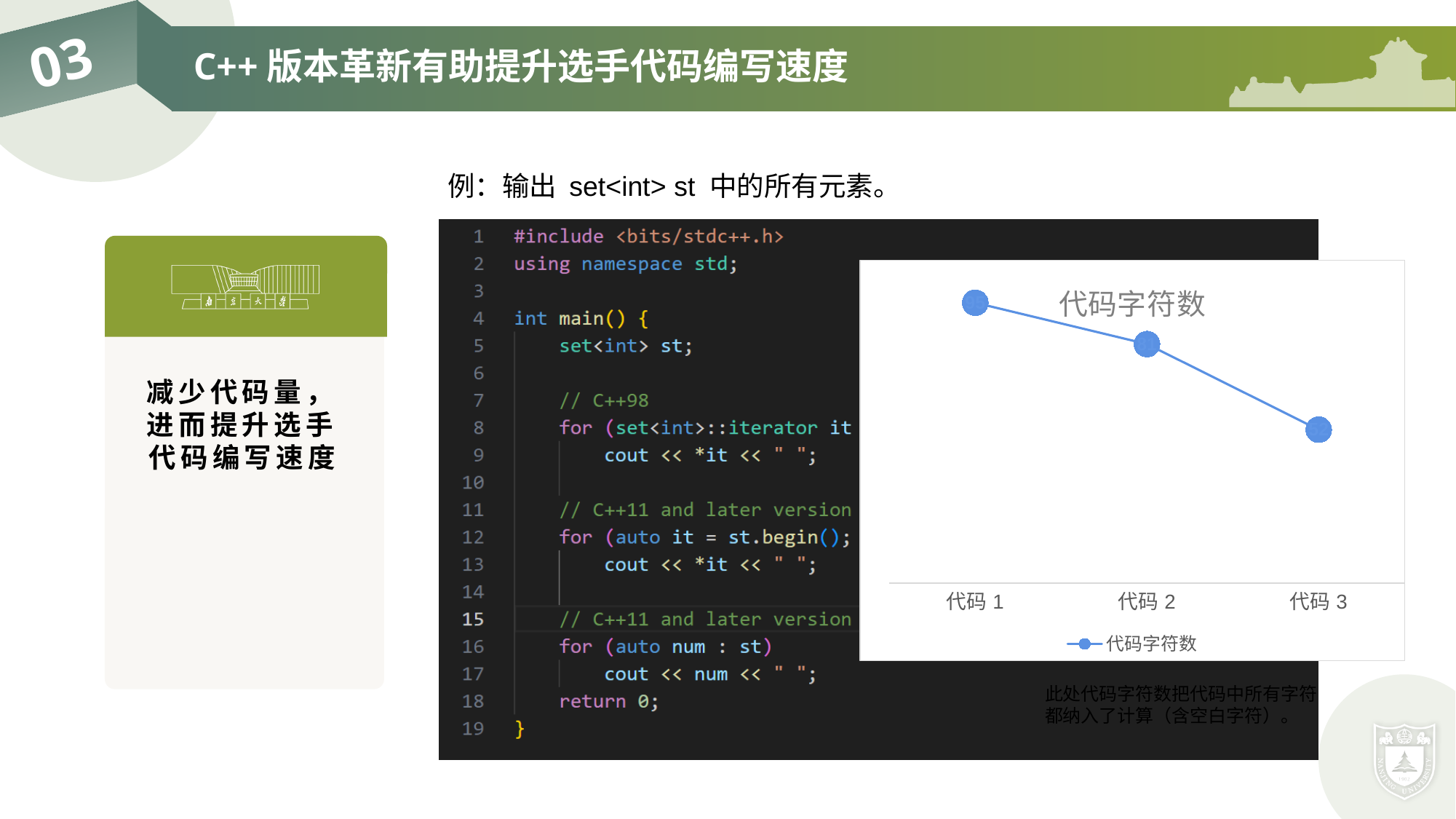
Do the values rise or fall from 代码 1 to 代码 3? fall What is the name of the series shown in the chart's legend? 代码字符数 What is the title of the chart? 代码字符数 Which has a larger value, 代码 1 or 代码 2? 代码 1 Which has a larger value, 代码 2 or 代码 3? 代码 2 What kind of chart is shown on the slide? line chart Which has a larger value, 代码 1 or 代码 3? 代码 1 How many categories are plotted on the x axis of the chart? 3 Which category has the lowest value in the chart? 代码 3 Which category has the highest value in the chart? 代码 1 How many series does the chart's legend list? 1